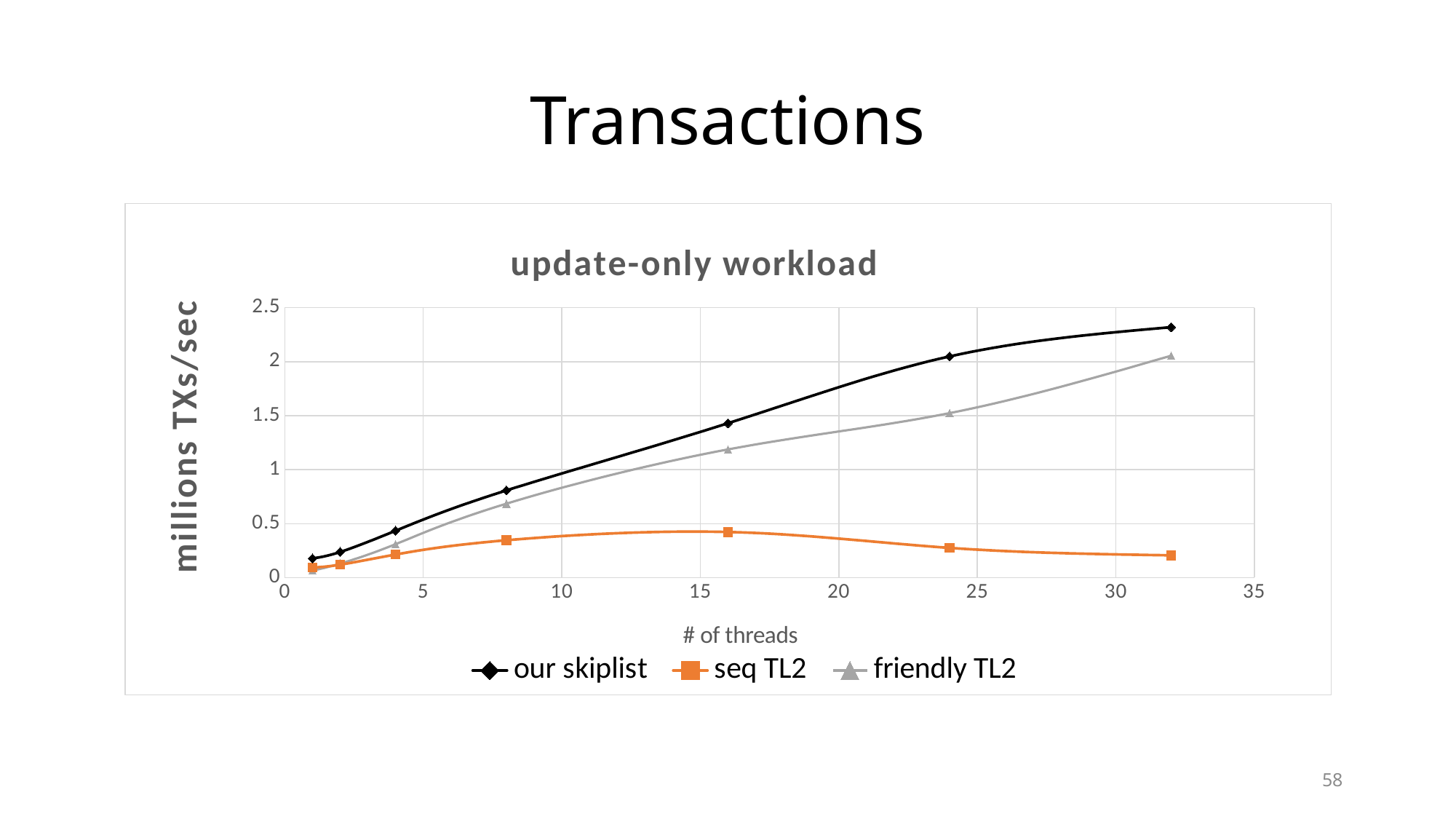
Does the 'our skiplist' series rise or fall as the number of threads increases? rise How many data points are plotted for the 'our skiplist' series? 7 How many series does the legend list? 3 At 16 threads, which is larger: 'friendly TL2' or 'seq TL2'? friendly TL2 Which series has the lowest value at 32 threads? seq TL2 Which series has the highest value at 32 threads? our skiplist What is the label of the y axis? millions TXs/sec What is the title of the chart? update-only workload Is the value for 'seq TL2' at 32 threads greater or less than 0.5? less Is the value for 'our skiplist' at 32 threads greater or less than 2? greater Is the value for 'friendly TL2' at 16 threads greater or less than 1? greater What kind of chart is shown on the slide? line chart